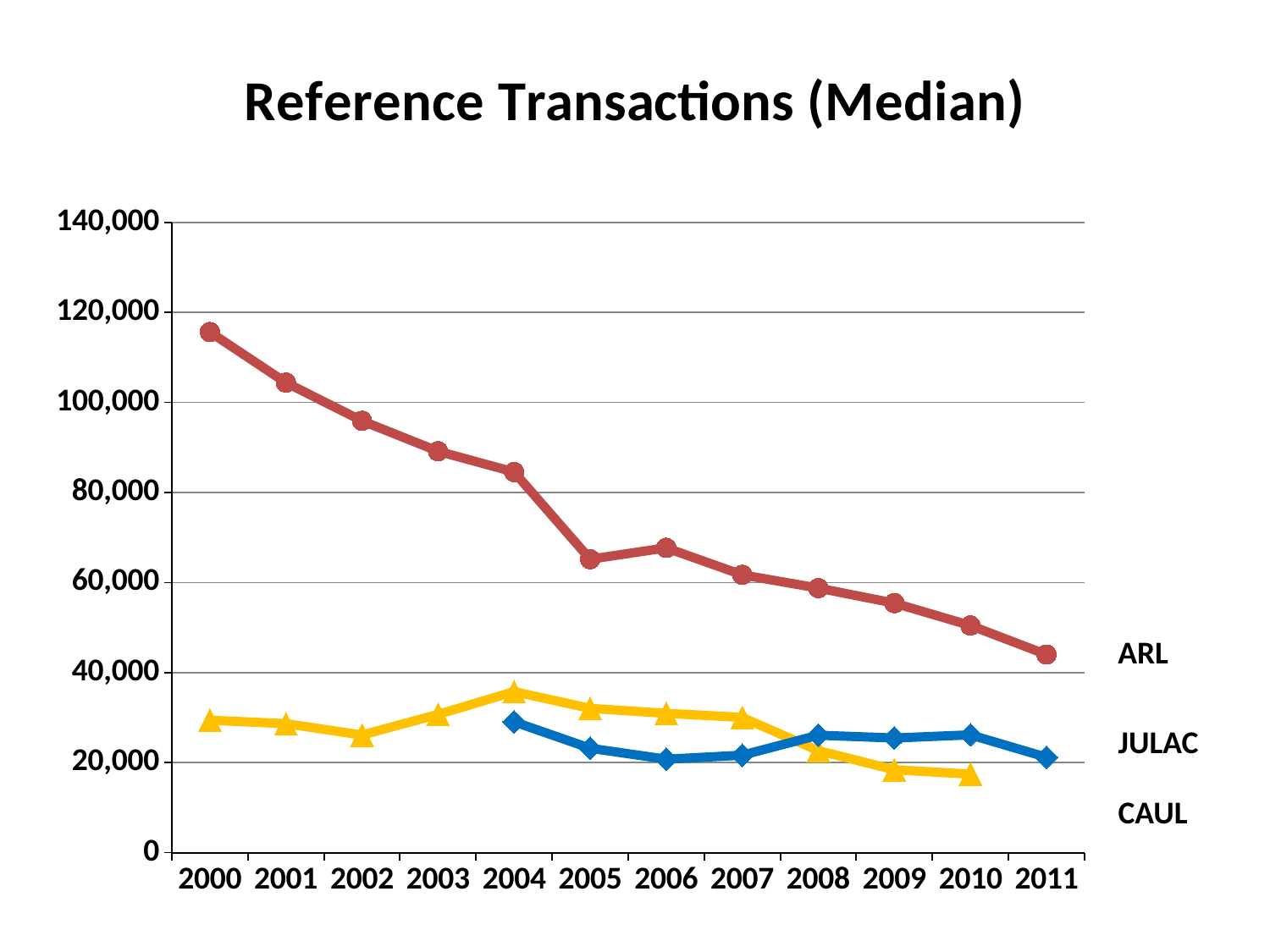
In which year is the ARL value highest? 2000 Which series is plotted with the red line and circle markers? ARL Does the ARL series rise or fall from 2000 to 2011? fall What kind of chart is shown on the slide? line chart What is the title of the chart? Reference Transactions (Median) Is the CAUL value for 2010 greater or less than 20,000? less How many years are shown along the x axis? 12 Which series has the larger value in 2009, JULAC or CAUL? JULAC Is the ARL value for 2000 greater or less than 100,000? greater Which series has the larger value in 2005, CAUL or JULAC? CAUL In which year is the ARL value lowest? 2011 How many series are plotted on the chart? 3